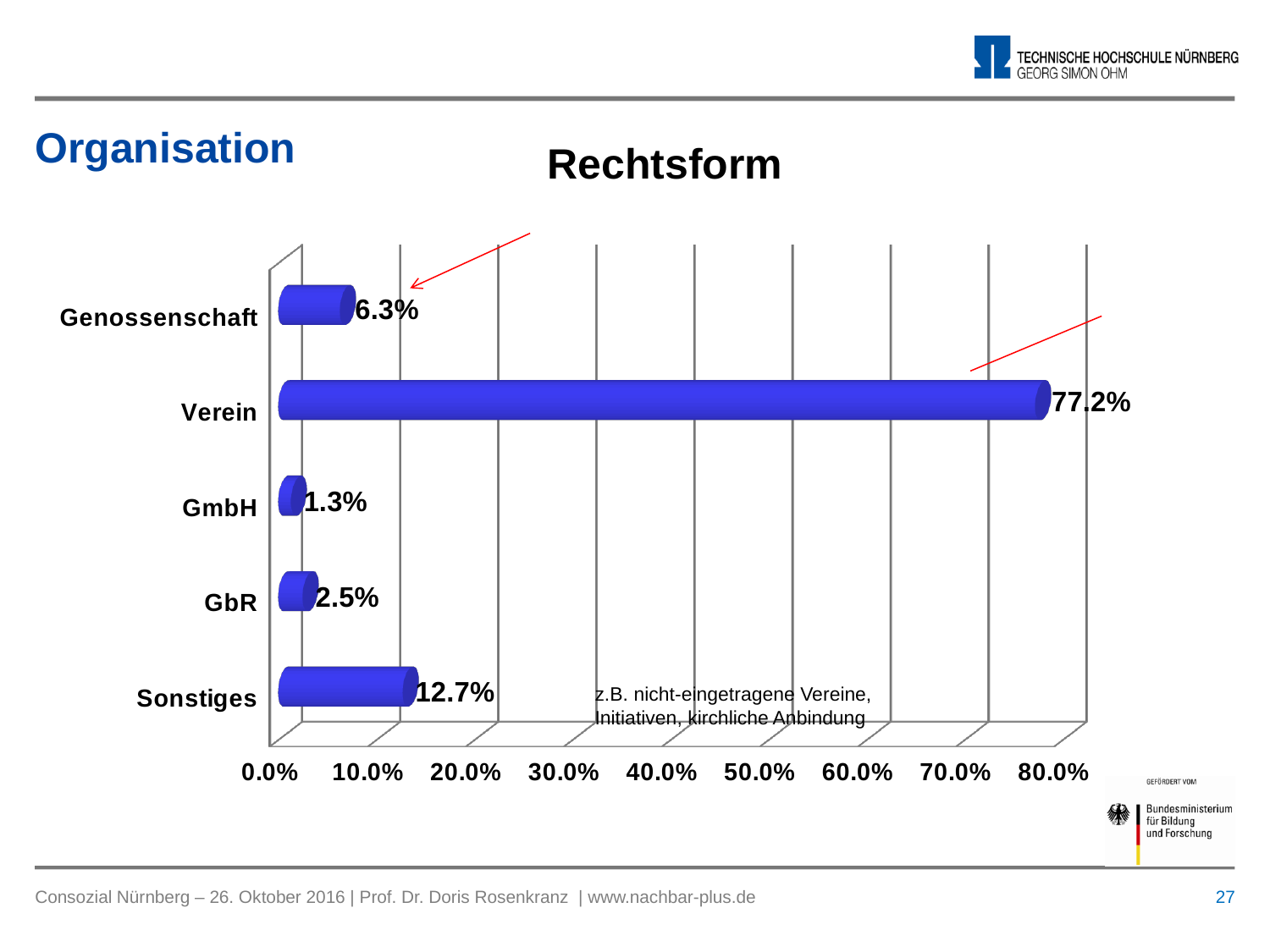
Is the value for Verein greater or less than 70.0%? greater Which is larger, the value for Genossenschaft or the value for GbR? Genossenschaft Which category has the highest value? Verein What is the difference between the values for Verein and Sonstiges? 64.5% What is the value for Verein? 77.2% How many categories are shown in the chart? 5 What kind of chart is shown on the slide? bar chart Which category has the lowest value? GmbH What is the value for Sonstiges? 12.7% What is the title of the chart? Rechtsform What is the value for GbR? 2.5% What is the value for Genossenschaft? 6.3%